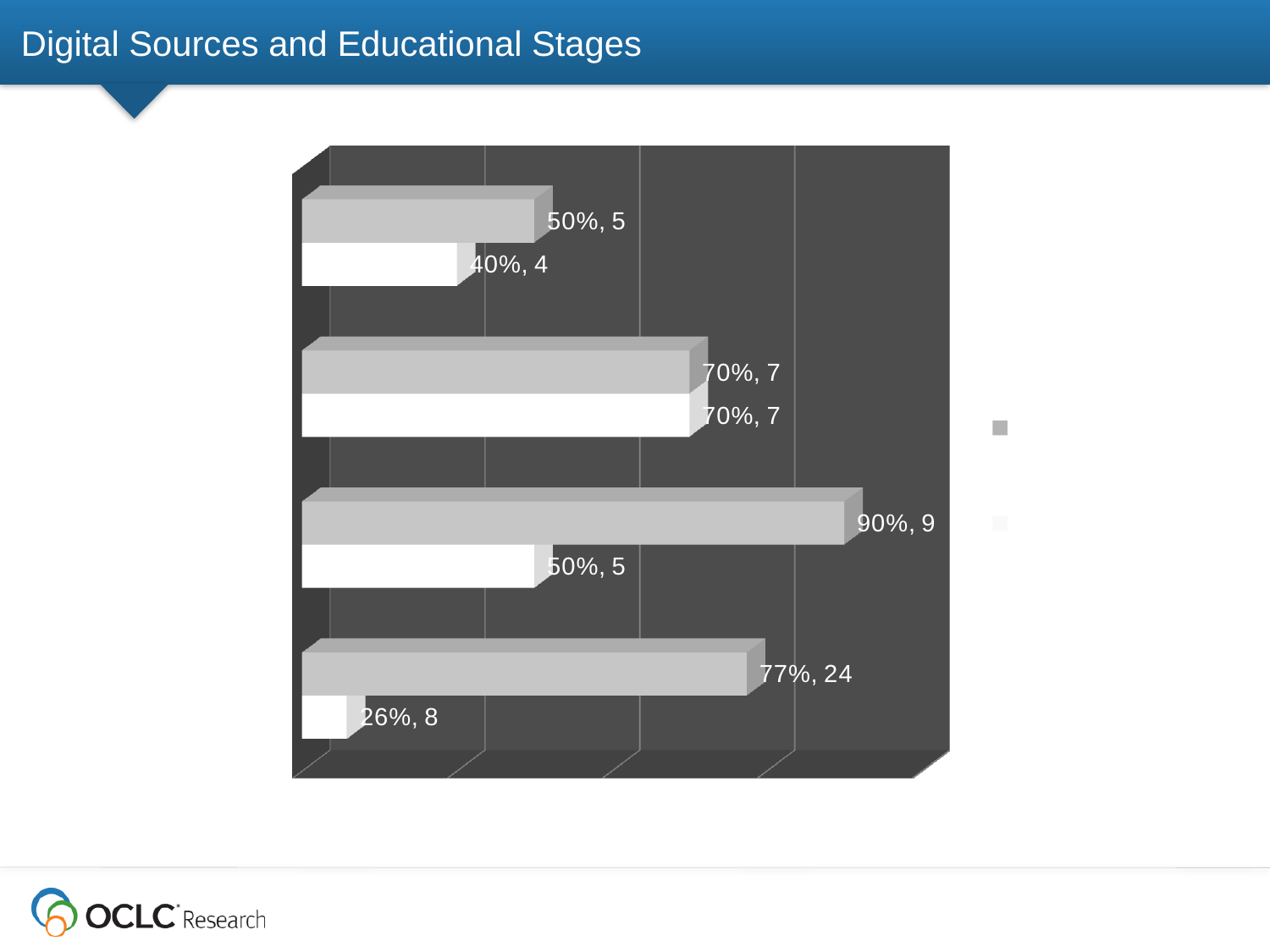
What is the data label on the white bar in the bottom group of bars? 26%, 8 What is the data label on the grey bar in the bottom group of bars? 77%, 24 Which group of bars has the lowest white-bar percentage? the bottom group (26%) How many groups of bars does the chart show? 4 What is the data label on the grey bar in the third group of bars from the top? 90%, 9 What kind of chart is shown on the slide? bar chart In the bottom group of bars, which is larger, the grey bar or the white bar? the grey bar How many series does the chart's legend list? 2 Which group of bars has the highest grey-bar percentage? the third group from the top (90%) In the third group of bars from the top, what is the difference in percentage points between the grey bar and the white bar? 40 percentage points What is the data label on the white bar in the top group of bars? 40%, 4 What is the data label on the grey bar in the top group of bars? 50%, 5